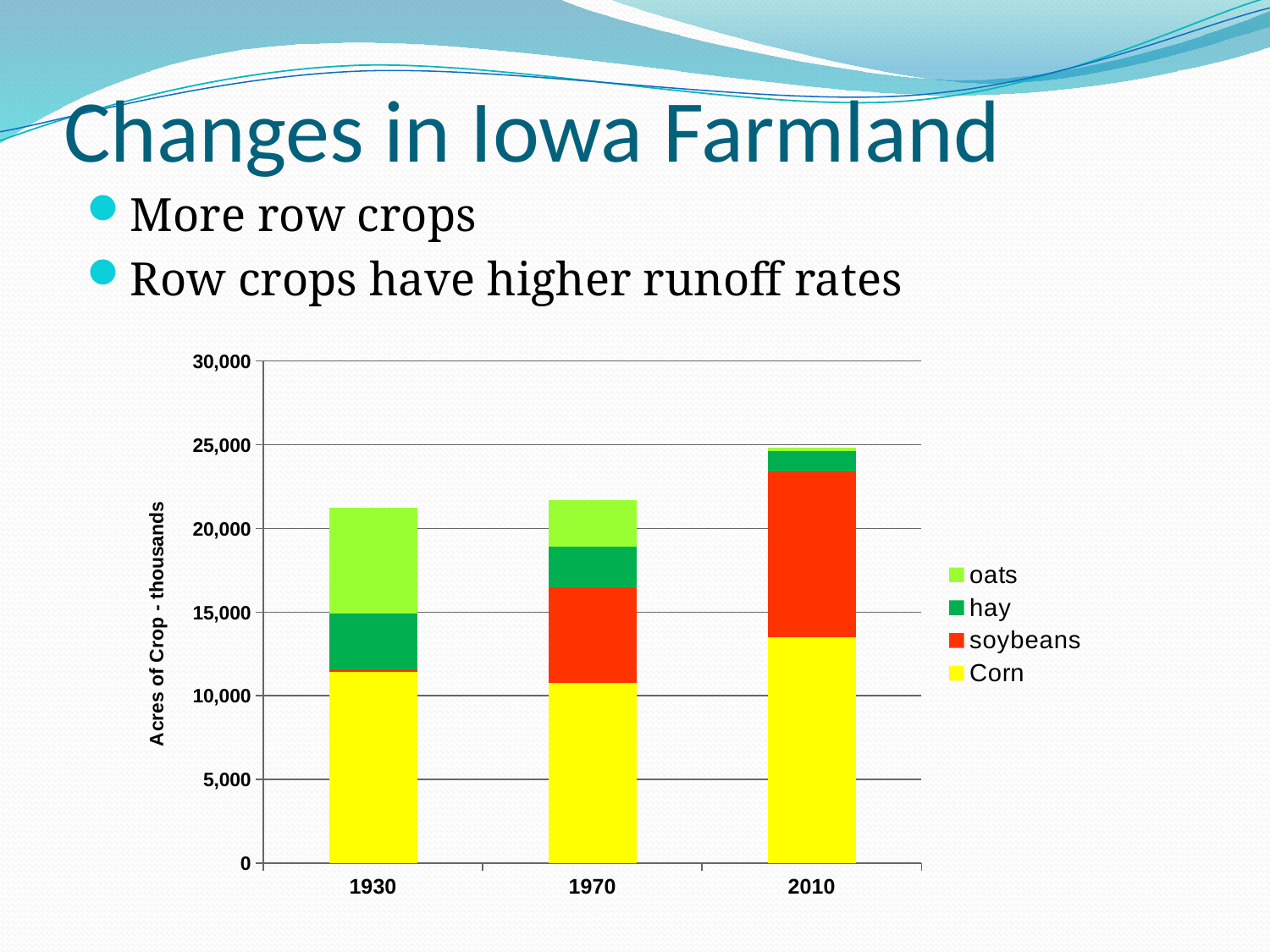
Which year has the highest total acres of crop? 2010 What is the label on the chart's y axis? Acres of Crop - thousands How many series does the chart's legend list? 4 Is the Corn value for 2010 greater or less than 10,000? greater How many years are shown along the x axis of the chart? 3 Is the total acres of crop for 2010 greater or less than 20,000? greater What kind of chart is shown on the slide? Stacked bar chart Which year has the larger oats segment, 1930 or 2010? 1930 Is the Corn value for 1970 greater or less than 15,000? less Do the soybeans acres rise or fall from 1930 to 2010? rise Which year has the larger soybeans segment, 1970 or 2010? 2010